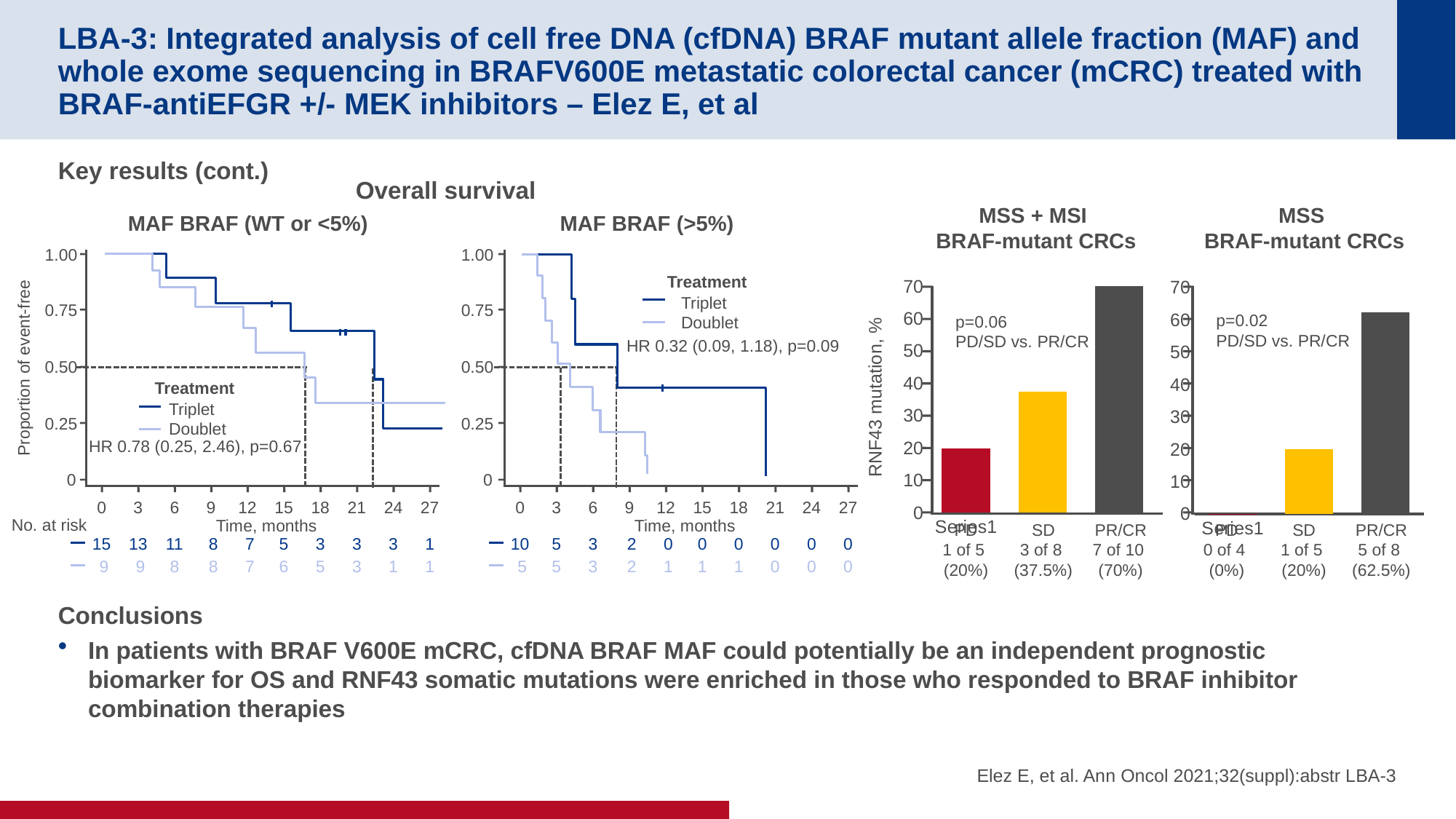
In the 'MSS BRAF-mutant CRCs' bar chart, how many response groups are shown? 3 In the 'MSS + MSI BRAF-mutant CRCs' bar chart, what is the RNF43 mutation percentage for the PR/CR group? 70% In the 'MAF BRAF (>5%)' overall survival chart, how many Triplet patients are at risk at time 0? 10 In the 'MAF BRAF (WT or <5%)' overall survival chart, what hazard ratio is reported? HR 0.78 (0.25, 2.46), p=0.67 In the 'MSS BRAF-mutant CRCs' bar chart, which response group has the highest RNF43 mutation percentage? PR/CR What type of chart is used for the 'MSS + MSI BRAF-mutant CRCs' panel? Bar chart In the 'MSS + MSI BRAF-mutant CRCs' bar chart, what is the difference in RNF43 mutation percentage between the PR/CR and PD groups? 50% In the 'MSS BRAF-mutant CRCs' bar chart, what is the difference in RNF43 mutation percentage between the PR/CR and SD groups? 42.5% In the 'MSS + MSI BRAF-mutant CRCs' bar chart, what is the RNF43 mutation percentage for the SD group? 37.5% In the 'MAF BRAF (WT or <5%)' overall survival chart, how many treatment groups does the legend list? 2 In the 'MSS + MSI BRAF-mutant CRCs' bar chart, which response group has the lowest RNF43 mutation percentage? PD In the 'MSS BRAF-mutant CRCs' bar chart, what is the RNF43 mutation percentage for the PD group? 0%